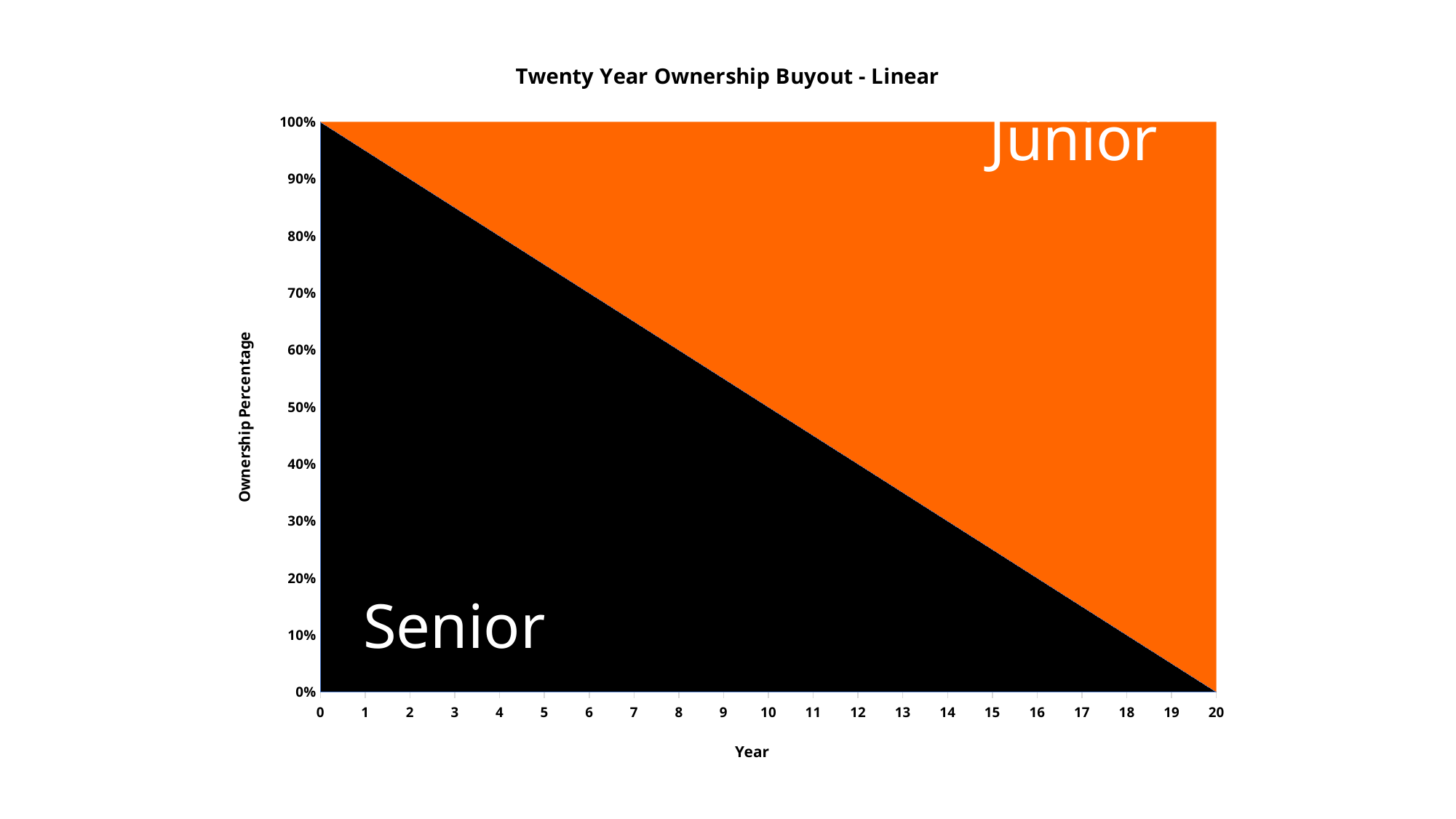
What is the title of the chart? Twenty Year Ownership Buyout - Linear What is the Senior ownership percentage at year 10? 50% At year 5, which is larger, the Senior or the Junior ownership percentage? Senior At year 10, what is the combined ownership percentage of Senior and Junior? 100% What is the Senior ownership percentage at year 0? 100% Does the Senior ownership percentage rise or fall as the year increases? fall Does the Junior ownership percentage rise or fall as the year increases? rise What kind of chart is shown on the slide? area chart What is the Senior ownership percentage at year 20? 0% What is the label on the x axis of the chart? Year Is the Senior ownership percentage at year 15 greater or less than 30%? less How many series are plotted in the chart? 2